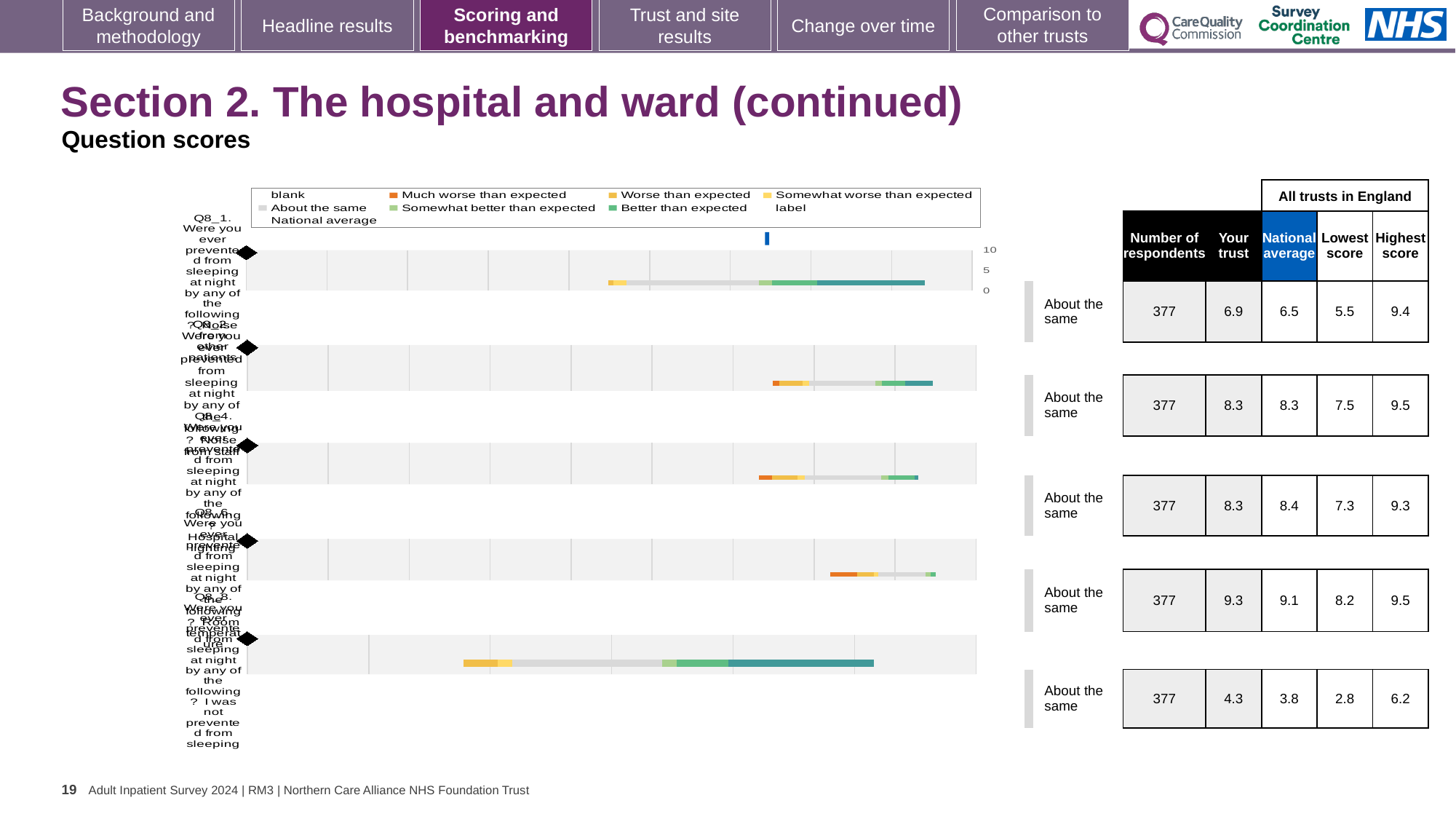
For the bottom chart (Q8_8, I was not prevented from sleeping), what is the national average score? 3.8 Which question has the lowest 'Your trust' score? Q8_8 (I was not prevented from sleeping) What kind of chart is used for the question scores on this slide? Bar chart For the fourth chart (Q8_6, room temperature), what is the lowest score among all trusts in England? 8.2 Which question has the highest 'Your trust' score? Q8_6 (Room temperature) How many respondents are listed for the second chart (Q8_2, noise from staff)? 377 For the second chart (Q8_2, noise from staff), what is the highest score among all trusts in England? 9.5 For the top chart (Q8_1, noise from other patients), what is the 'Your trust' score? 6.9 What benchmark category is shown next to each of the five charts? About the same How many benchmark charts are shown on the slide? 5 For the top chart (Q8_1), what is the difference between the 'Your trust' score and the national average? 0.4 For the third chart (Q8_4, hospital lighting), which is larger: the 'Your trust' score or the national average? National average